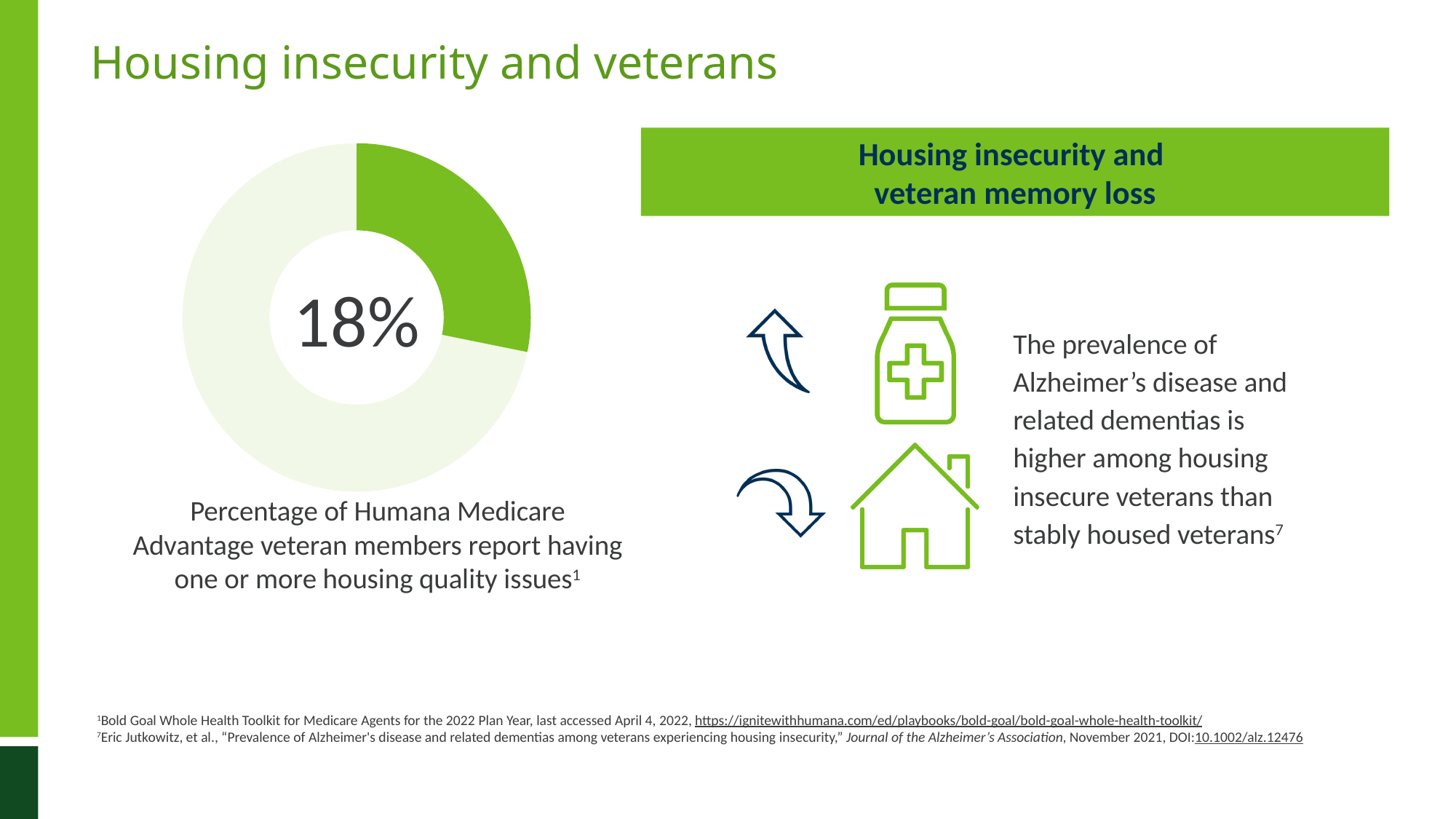
Which segment of the donut chart is larger, the dark green segment or the light green segment? The light green segment Is the value shown in the donut chart greater or less than 10%? greater What percentage is shown in the centre of the donut chart? 18% What colour is the segment of the donut chart that represents the 18% value? Dark green Is the value shown in the donut chart greater or less than 50%? less What kind of chart is shown on the left of the slide? Donut chart How many segments does the donut chart have? 2 According to the donut chart, what percentage of Humana Medicare Advantage veteran members report having one or more housing quality issues? 18% What is the title of the slide containing the donut chart? Housing insecurity and veterans